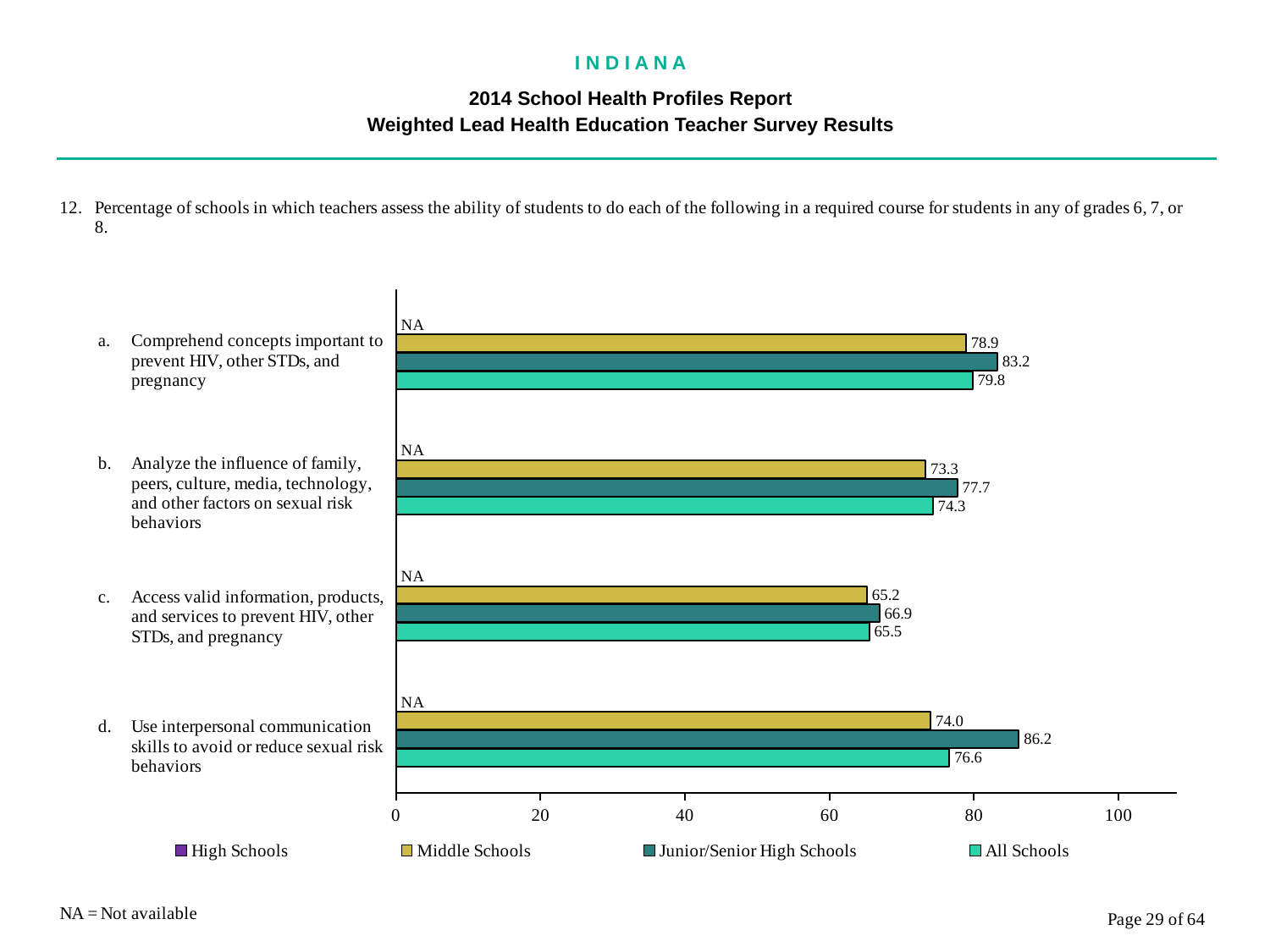
What value is shown for High Schools in each category? NA What is the Junior/Senior High Schools value for 'Use interpersonal communication skills to avoid or reduce sexual risk behaviors'? 86.2 What does NA stand for according to the note on the slide? Not available What is the All Schools value for 'Access valid information, products, and services to prevent HIV, other STDs, and pregnancy'? 65.5 What is the Middle Schools value for 'Comprehend concepts important to prevent HIV, other STDs, and pregnancy'? 78.9 For 'Analyze the influence of family, peers, culture, media, technology, and other factors on sexual risk behaviors', which is larger: the Middle Schools value or the All Schools value? All Schools What kind of chart is shown on the slide? Bar chart How many series does the legend list? 4 What is the difference between the Junior/Senior High Schools and Middle Schools values for 'Use interpersonal communication skills to avoid or reduce sexual risk behaviors'? 12.2 Which category has the lowest Middle Schools value? Access valid information, products, and services to prevent HIV, other STDs, and pregnancy Which category has the highest Junior/Senior High Schools value? Use interpersonal communication skills to avoid or reduce sexual risk behaviors How many categories (items a–d) are plotted in the chart? 4